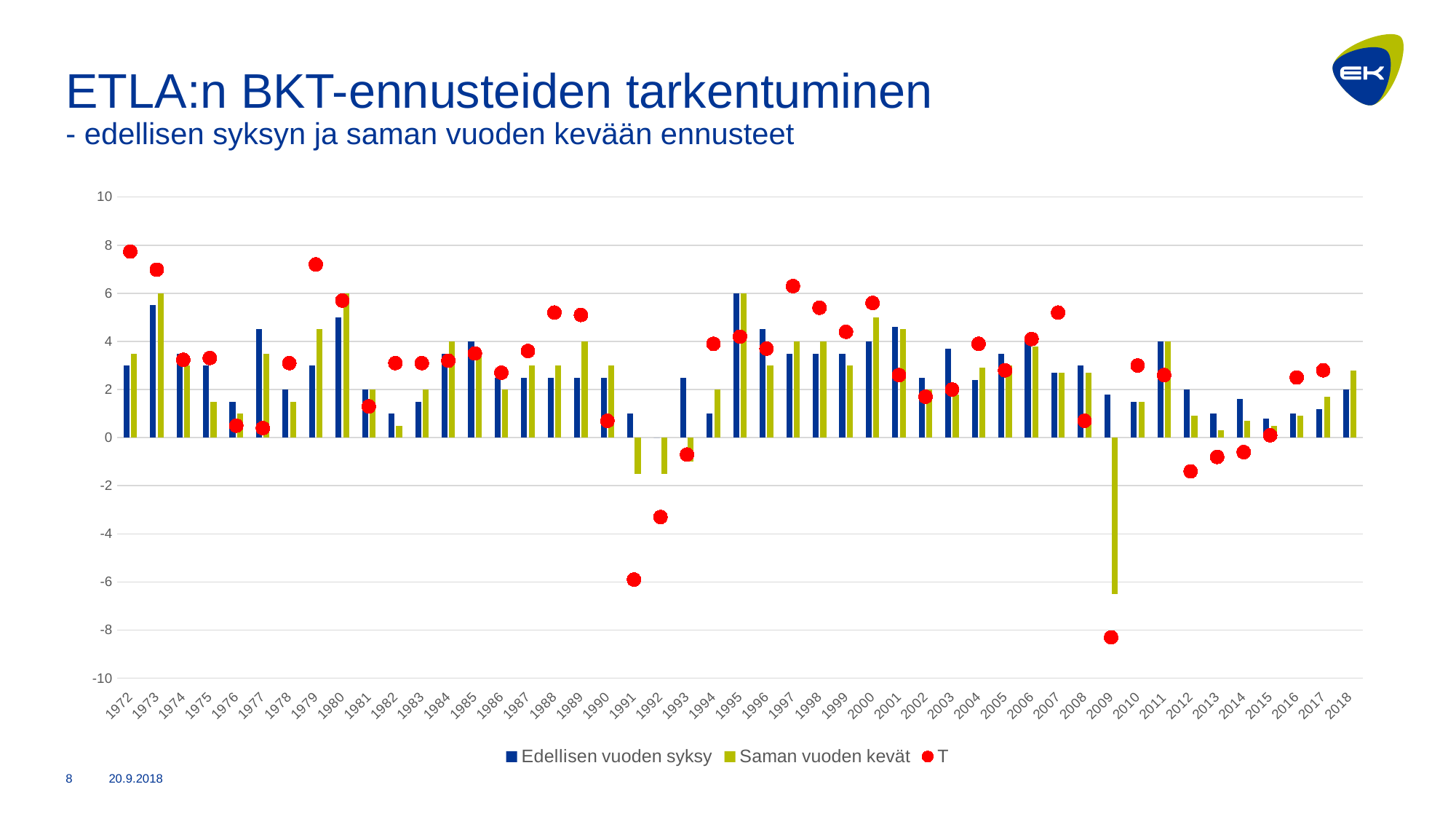
What are the three series named in the legend? Edellisen vuoden syksy, Saman vuoden kevät, T What colour are the markers for the T series? red Is the Saman vuoden kevät value for 1991 greater or less than 0? less Is the T value for 1992 greater or less than -2? less In which year is the T value lowest? 2009 Is the Saman vuoden kevät value for 2009 greater or less than -4? less What kind of chart is used for the Edellisen vuoden syksy and Saman vuoden kevät series? bar chart In which year is the Saman vuoden kevät bar lowest? 2009 How many years are shown on the x axis? 47 How many series does the legend list? 3